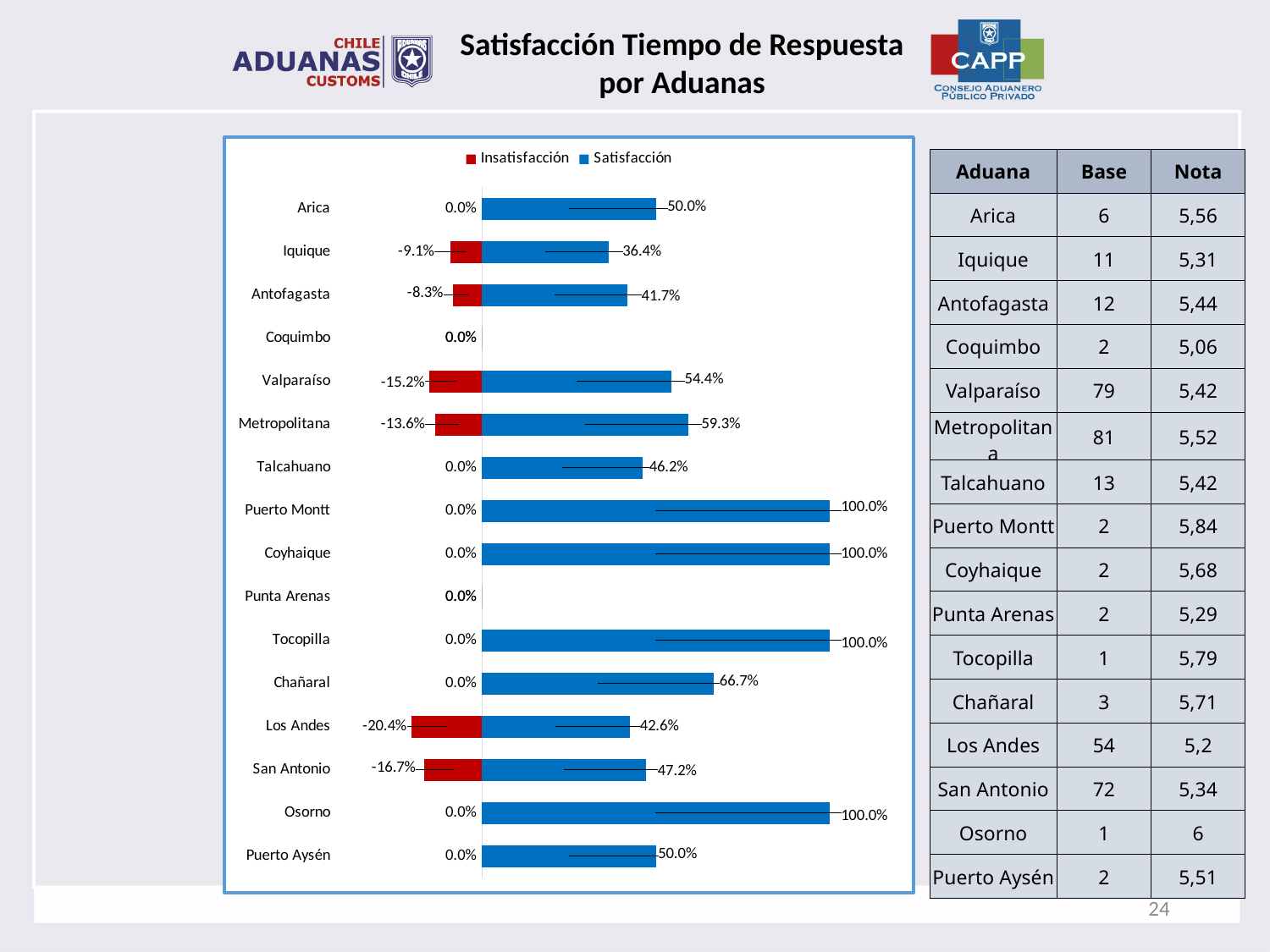
Which aduana has the largest Insatisfacción value (furthest from zero)? Los Andes What is the Satisfacción value for Chañaral? 66.7% What type of chart is shown on the slide? bar chart How many series does the chart legend list? 2 What is the Insatisfacción value for Valparaíso? -15.2% Which has a higher Satisfacción value, San Antonio or Talcahuano? San Antonio How many aduanas (categories) are listed on the chart's vertical axis? 16 What is the Satisfacción value for Metropolitana? 59.3% What is the Insatisfacción value for Los Andes? -20.4% What is the difference between the Satisfacción values for Metropolitana and Valparaíso? 4.9 percentage points Which aduana has the lowest non-zero Satisfacción value? Iquique Which colour represents the Insatisfacción series in the chart? red